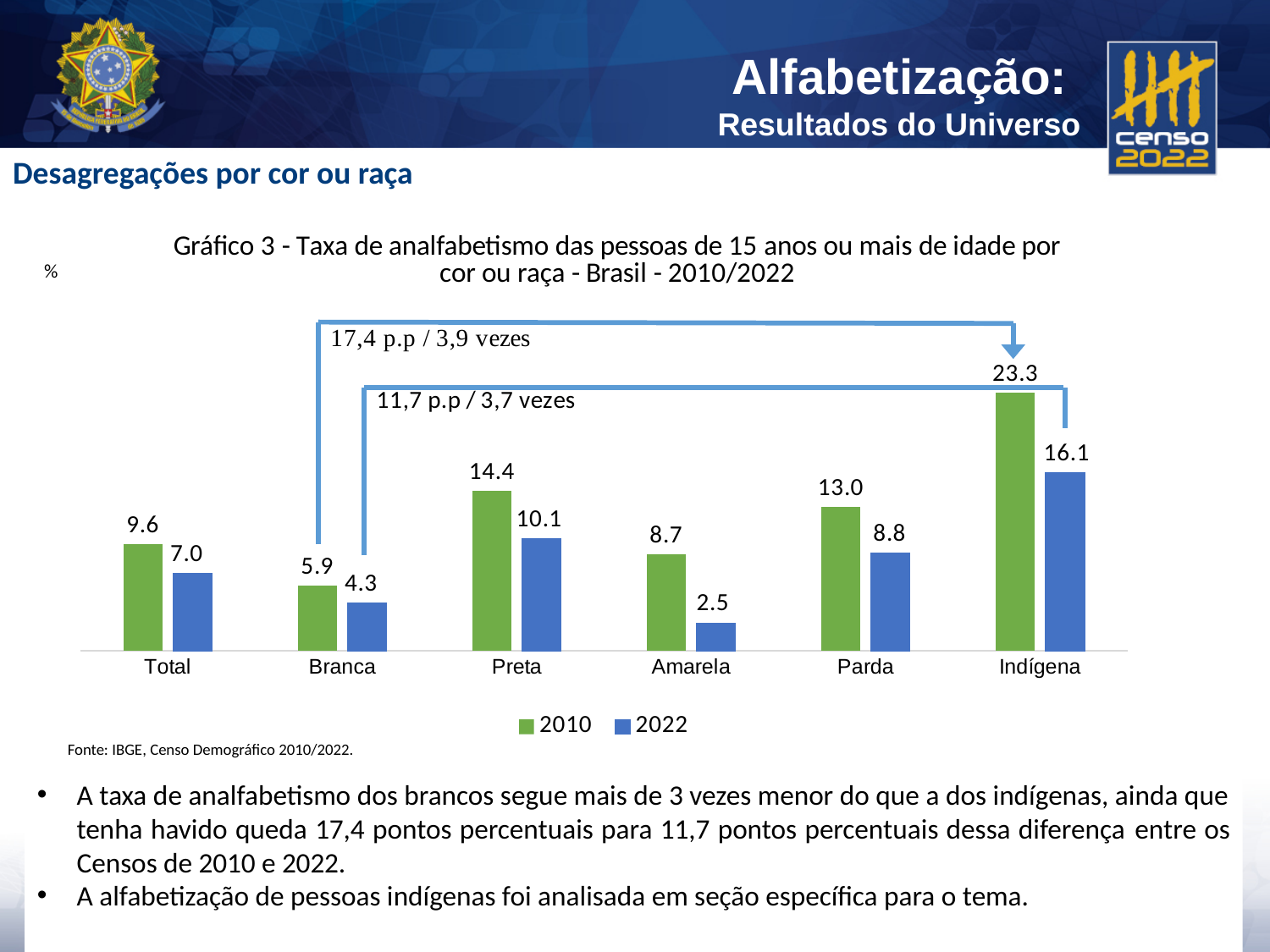
What kind of chart is shown? bar chart What is the difference between the 2010 and 2022 values for Total? 2.6 Which category has the lowest value in 2022? Amarela Which colour represents the 2022 series? blue What is the difference between the Indígena and Branca values in 2022? 11.8 Which is larger, the 2022 value for Parda or the 2022 value for Preta? Preta Which category has the highest value in 2010? Indígena What is the illiteracy rate for Preta in 2010? 14.4 What is the illiteracy rate for Indígena in 2022? 16.1 How many series does the legend list? 2 How many categories are shown on the x axis? 6 What is the value for Amarela in 2022? 2.5